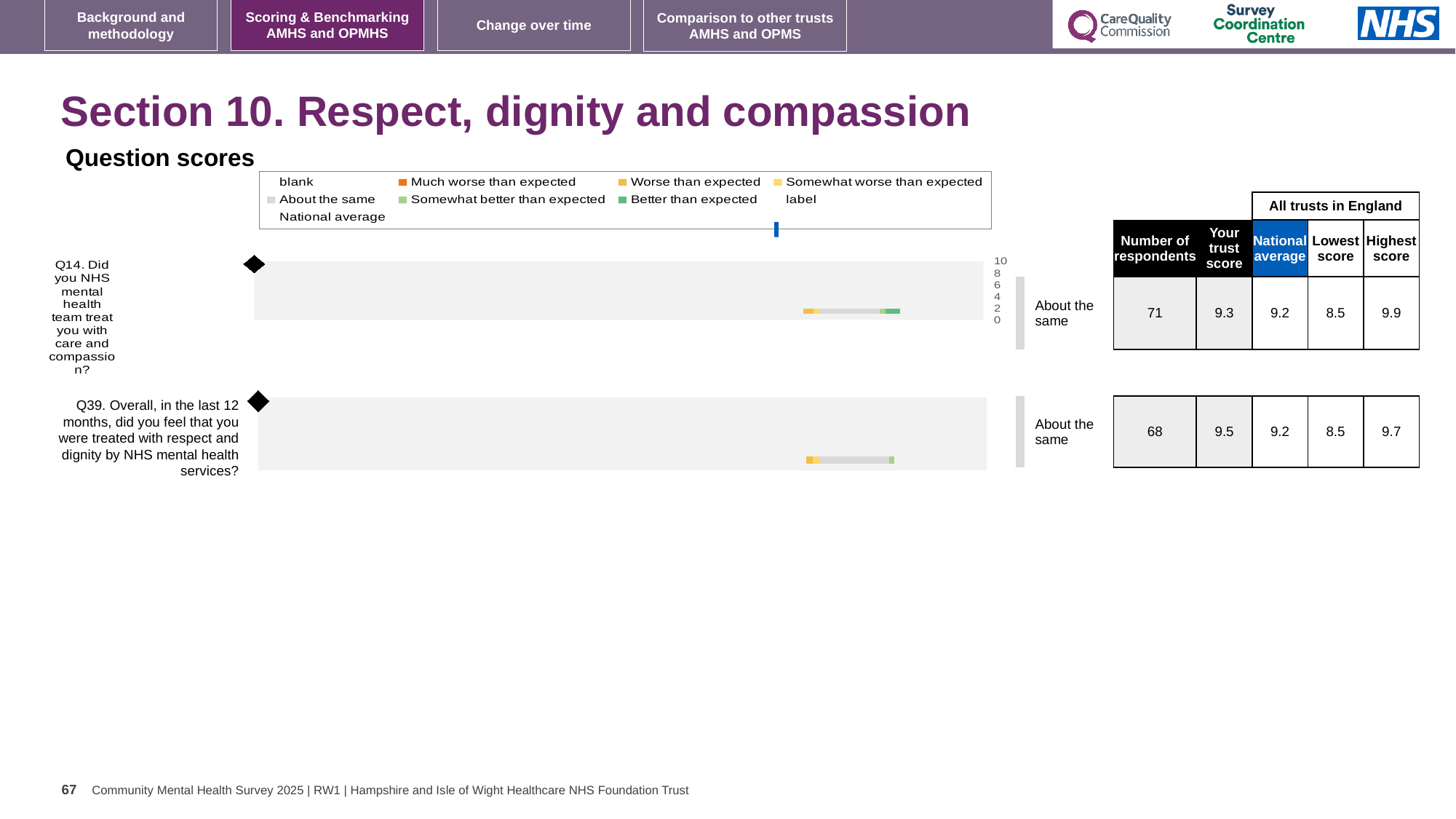
In the Question scores chart, what is the national average for Q14? 9.2 In the Question scores chart, how much higher is the trust score for Q14 than the national average for Q14? 0.1 What is the title of the chart on this slide? Question scores In the Question scores chart, what is the trust score for Q39? 9.5 What kind of chart is used to show the question scores on this slide? bar chart How many questions are plotted in the Question scores chart? 2 In the Question scores chart, what benchmark category is shown for Q14? About the same In the Question scores chart legend, which category is shown in dark orange? Much worse than expected In the Question scores chart, what is the highest score across all trusts in England for Q39? 9.7 In the Question scores chart, what is the difference between the highest score for Q14 (9.9) and the highest score for Q39 (9.7)? 0.2 In the Question scores chart, which question has the higher trust score, Q14 or Q39? Q39 In the Question scores chart, what is the number of respondents for Q14? 71